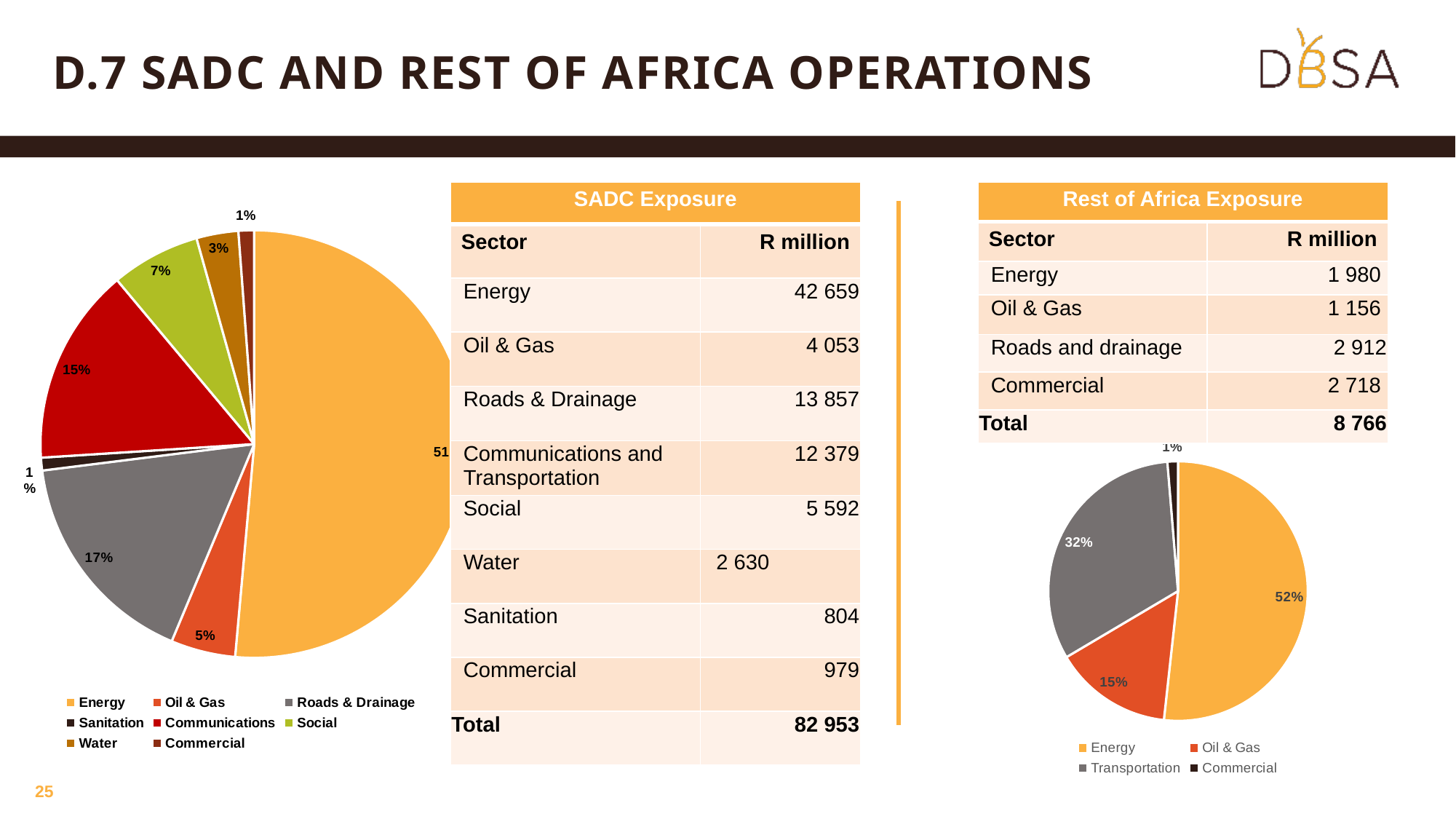
How many entries does the legend of the left pie chart list? 8 In the left pie chart, what share does Roads & Drainage have? 17% In the left pie chart, what share does Communications have? 15% In the left pie chart, which sector has the largest slice? Energy How many slices does the right pie chart have? 4 In the left pie chart, what share does Social have? 7% In the right pie chart, what is the difference between the Energy share and the Oil & Gas share? 37% In the left pie chart, which is larger, the Roads & Drainage slice or the Communications slice? Roads & Drainage What type of chart is shown on the left side of the slide? pie chart